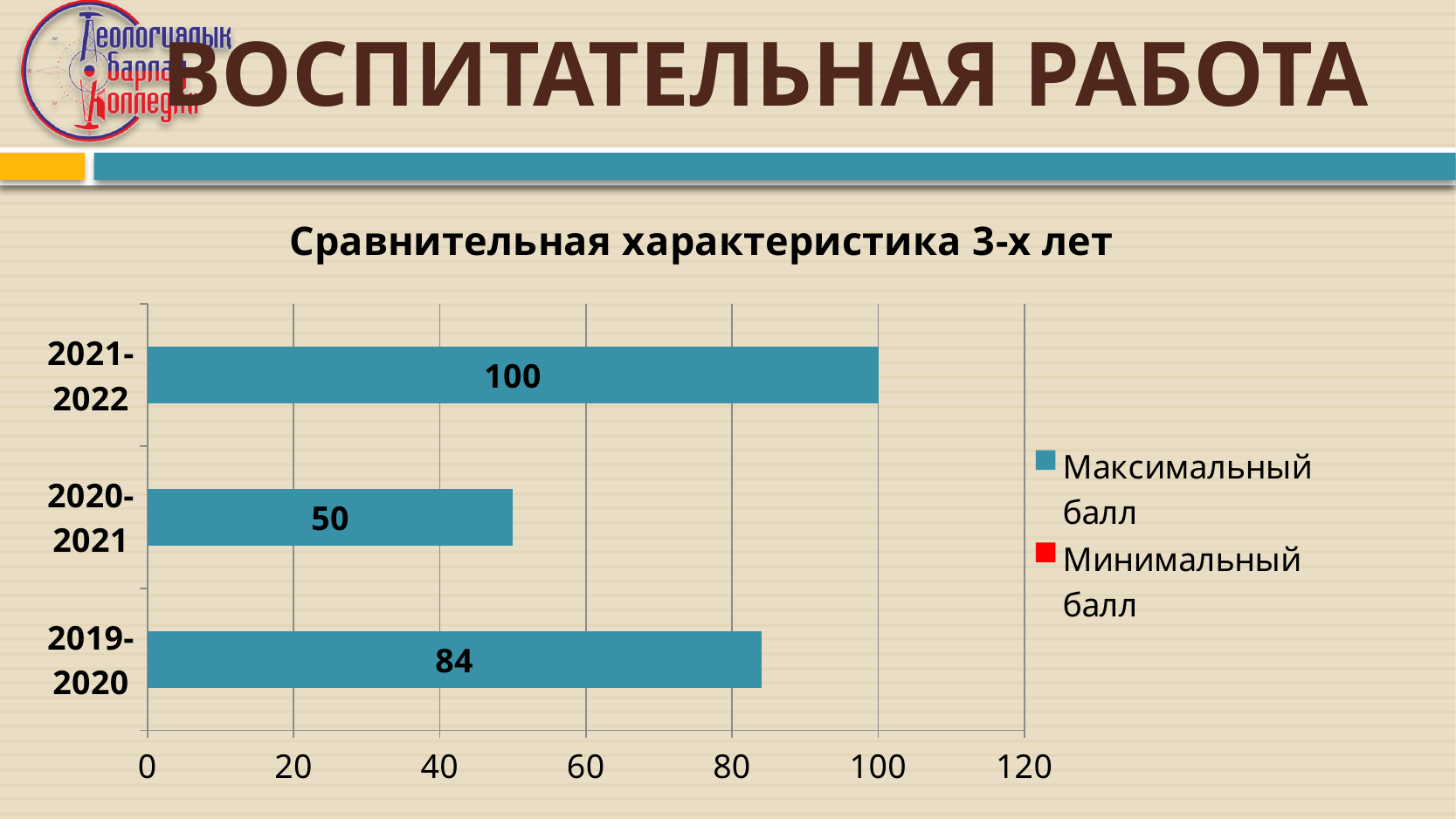
How many categories are shown on the chart? 3 What is the value for 2021-2022? 100 What kind of chart is shown? bar chart Which year has the highest value? 2021-2022 How many series does the legend list? 2 What is the difference between the values for 2019-2020 and 2020-2021? 34 What is the value for 2020-2021? 50 What is the title of the chart? Сравнительная характеристика 3-х лет Which year has the lowest value? 2020-2021 Which is larger, the value for 2019-2020 or the value for 2020-2021? 2019-2020 What is the difference between the values for 2021-2022 and 2020-2021? 50 What is the value for 2019-2020? 84